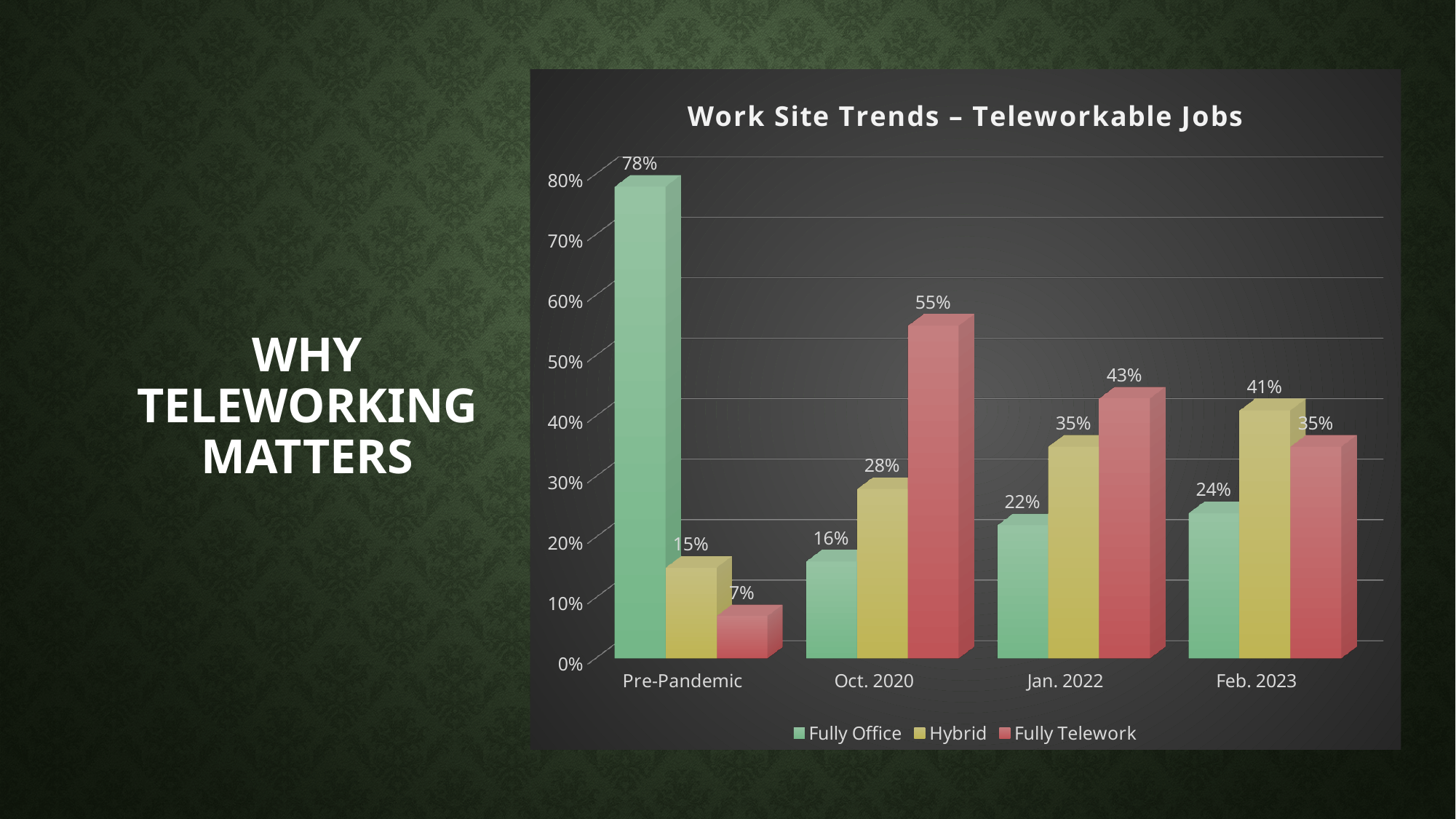
What kind of chart is shown? Bar chart What is the Fully Telework value for Oct. 2020? 55% What is the Hybrid value for Feb. 2023? 41% What is the title of the chart? Work Site Trends – Teleworkable Jobs Which category has the lowest Hybrid value? Pre-Pandemic How many categories are shown on the x axis? 4 What is the Fully Office value for Pre-Pandemic? 78% For Feb. 2023, which is larger: Hybrid or Fully Telework? Hybrid How many series does the legend list? 3 What is the Fully Office value for Jan. 2022? 22% Which category has the highest Fully Telework value? Oct. 2020 What is the difference between the Fully Telework and Fully Office values for Oct. 2020? 39%